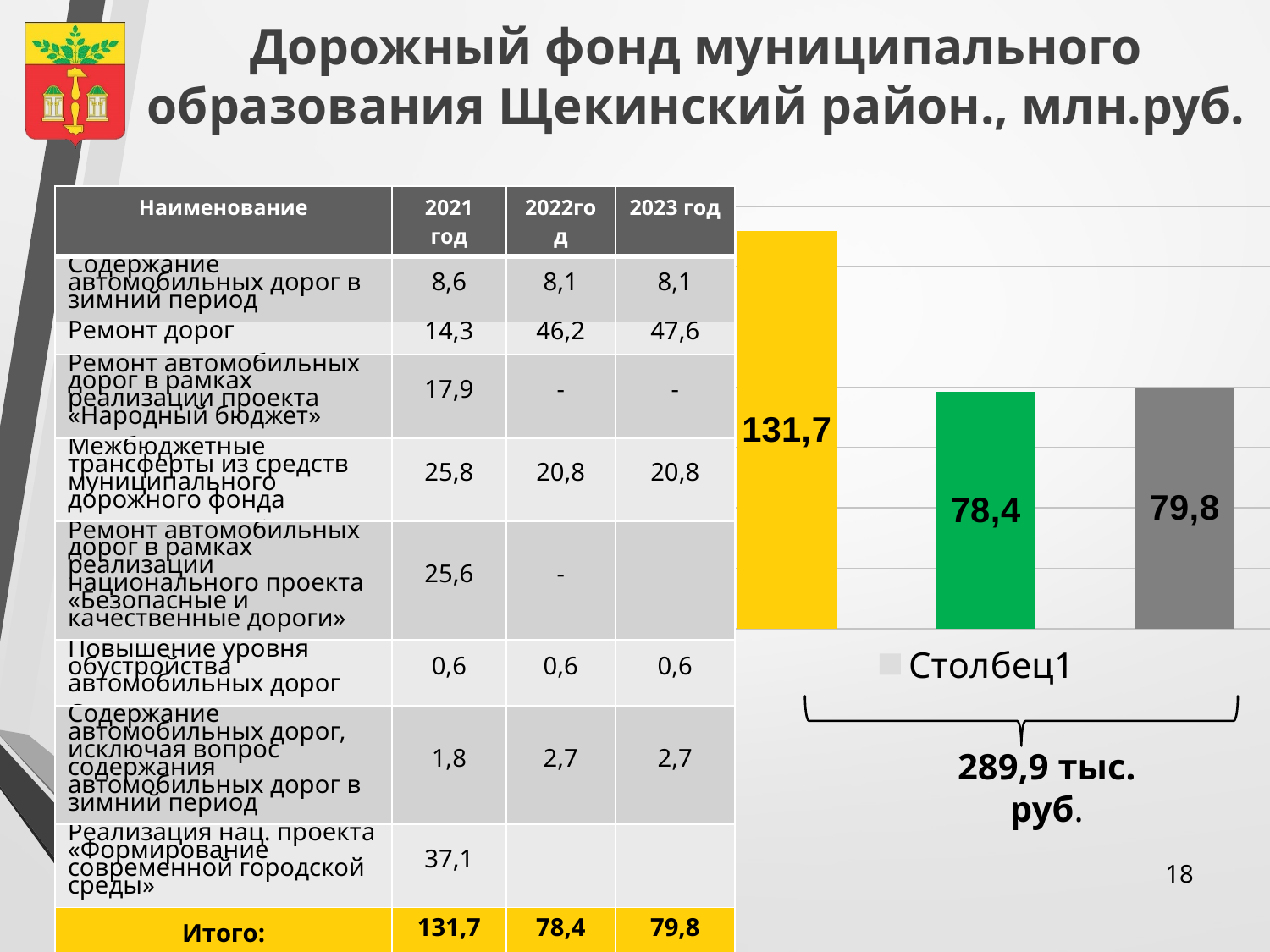
What type of chart is shown on the right side of the slide? bar chart How many series does the chart legend list? 1 Which bar in the chart has the lowest value? the middle (green) bar, 78,4 How many bars are plotted in the chart? 3 What is the legend entry shown below the chart? Столбец1 What is the difference between the leftmost bar (131,7) and the middle bar (78,4) in the chart? 53,3 What is the difference between the rightmost bar (79,8) and the middle bar (78,4) in the chart? 1,4 What is the value shown on the leftmost (yellow) bar of the chart? 131,7 What is the value shown on the rightmost (grey) bar of the chart? 79,8 What is the value shown on the middle (green) bar of the chart? 78,4 Which is larger in the chart: the leftmost bar or the rightmost bar? the leftmost bar (131,7) Which bar in the chart has the highest value? the leftmost (yellow) bar, 131,7